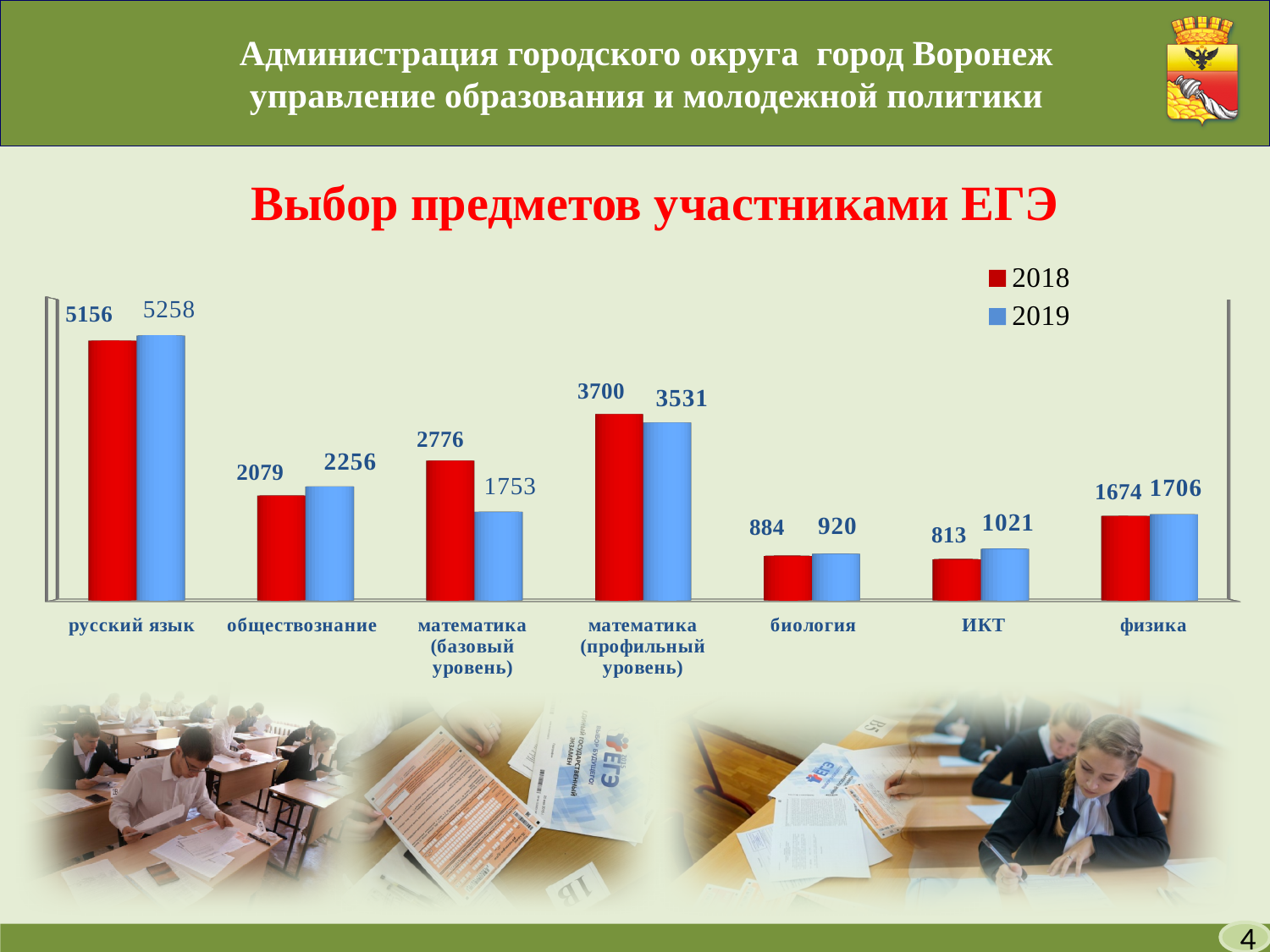
How many series does the legend list? 2 What is the value for ИКТ in 2018? 813 Which subject has the highest value in 2018? русский язык What is the difference between the 2019 and 2018 values for ИКТ? 208 What is the value for математика (базовый уровень) in 2019? 1753 How many subject categories are shown on the x axis? 7 Which subject has the lowest value in 2019? биология Which is larger for математика (профильный уровень): the 2018 value or the 2019 value? 2018 What is the title of the chart? Выбор предметов участниками ЕГЭ What is the difference between the 2018 and 2019 values for математика (базовый уровень)? 1023 What is the value for русский язык in 2019? 5258 What type of chart is shown on the slide? bar chart